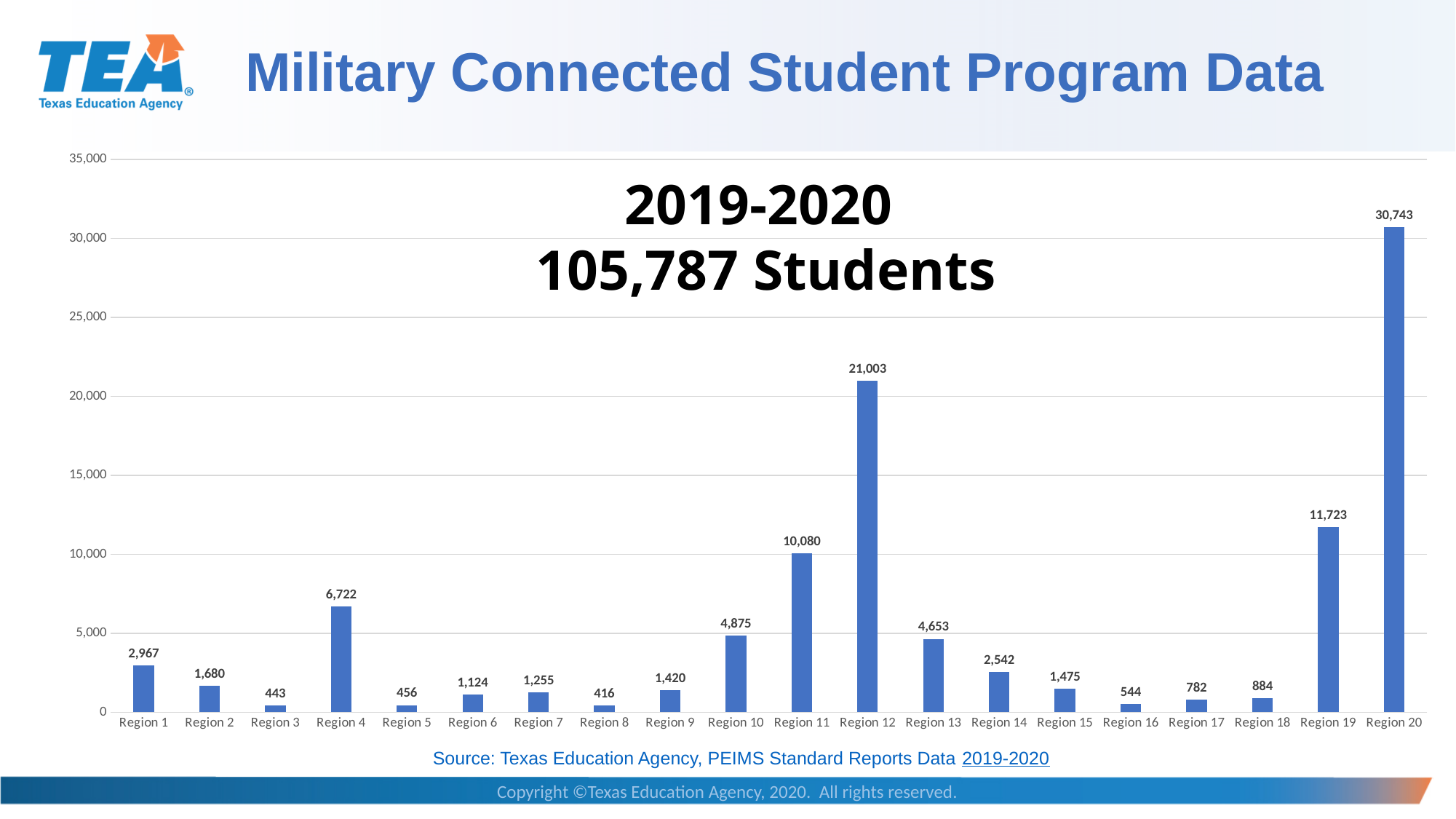
Is the value for Region 12 greater or less than 20,000? greater Which is larger, the value for Region 10 or the value for Region 13? Region 10 What is the difference between the values for Region 1 and Region 2? 1,287 What kind of chart is shown on the slide? bar chart What is the difference between the values for Region 12 and Region 19? 9,280 What total number of students is stated on the chart for 2019-2020? 105,787 Students How many regions are shown on the chart? 20 What is the value for Region 4? 6,722 Which region has the lowest value? Region 8 What is the value for Region 20? 30,743 Which region has the highest value? Region 20 What is the value for Region 11? 10,080